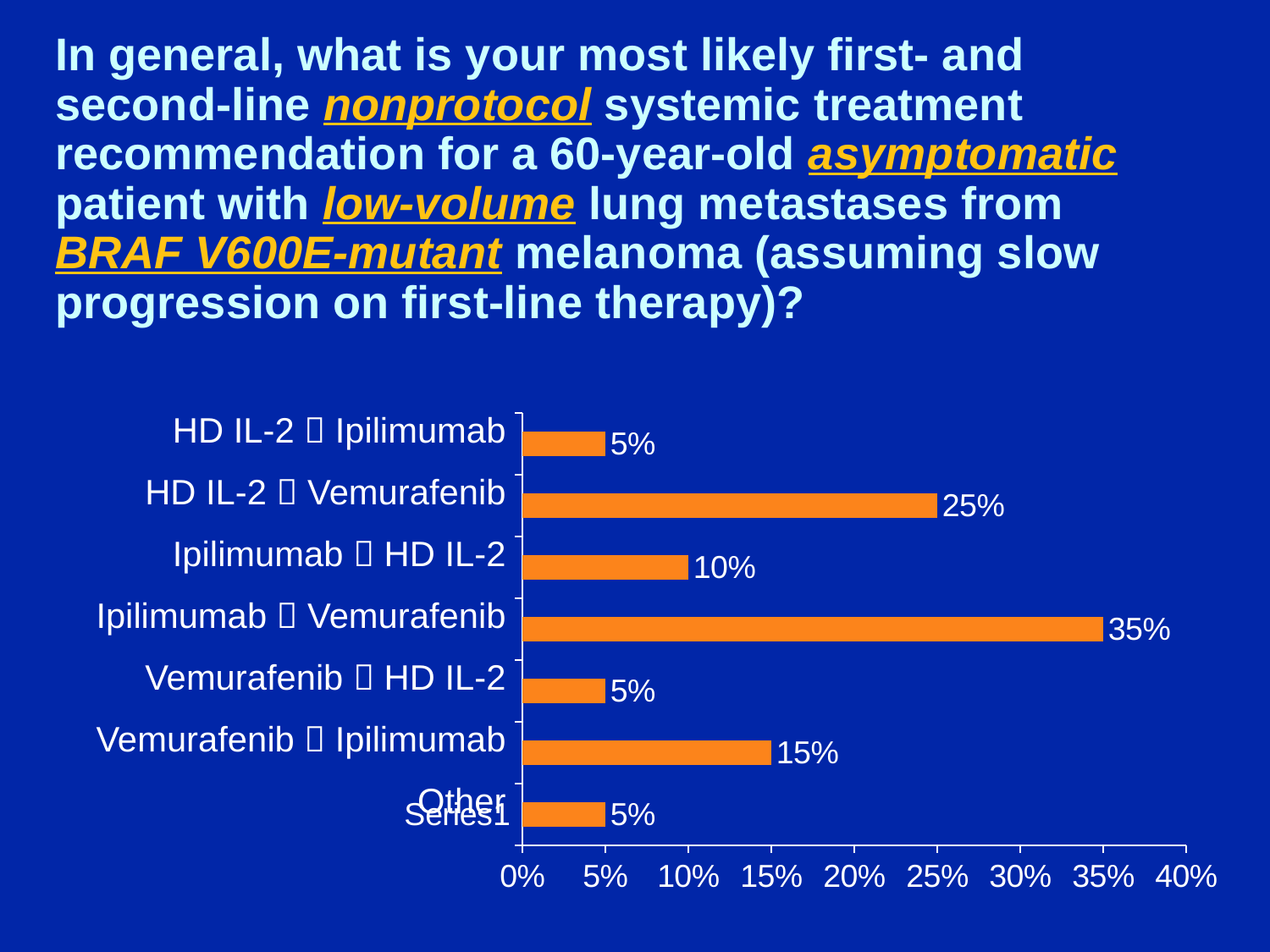
What percentage of respondents chose Ipilimumab → Vemurafenib? 35% What is the maximum value shown on the x axis of the chart? 40% Which is larger, the value for Vemurafenib → Ipilimumab or the value for Ipilimumab → HD IL-2? Vemurafenib → Ipilimumab What is the value for Ipilimumab → HD IL-2? 10% What is the difference between the values for Ipilimumab → Vemurafenib and HD IL-2 → Vemurafenib? 10% What kind of chart is shown on the slide? Bar chart What is the value shown for the Other category? 5% What percentage is shown for Vemurafenib → Ipilimumab? 15% Which treatment sequence has the highest percentage? Ipilimumab → Vemurafenib What is the value shown for HD IL-2 → Vemurafenib? 25% How many categories have a value of 5%? 3 How many treatment sequence categories are shown in the chart? 7